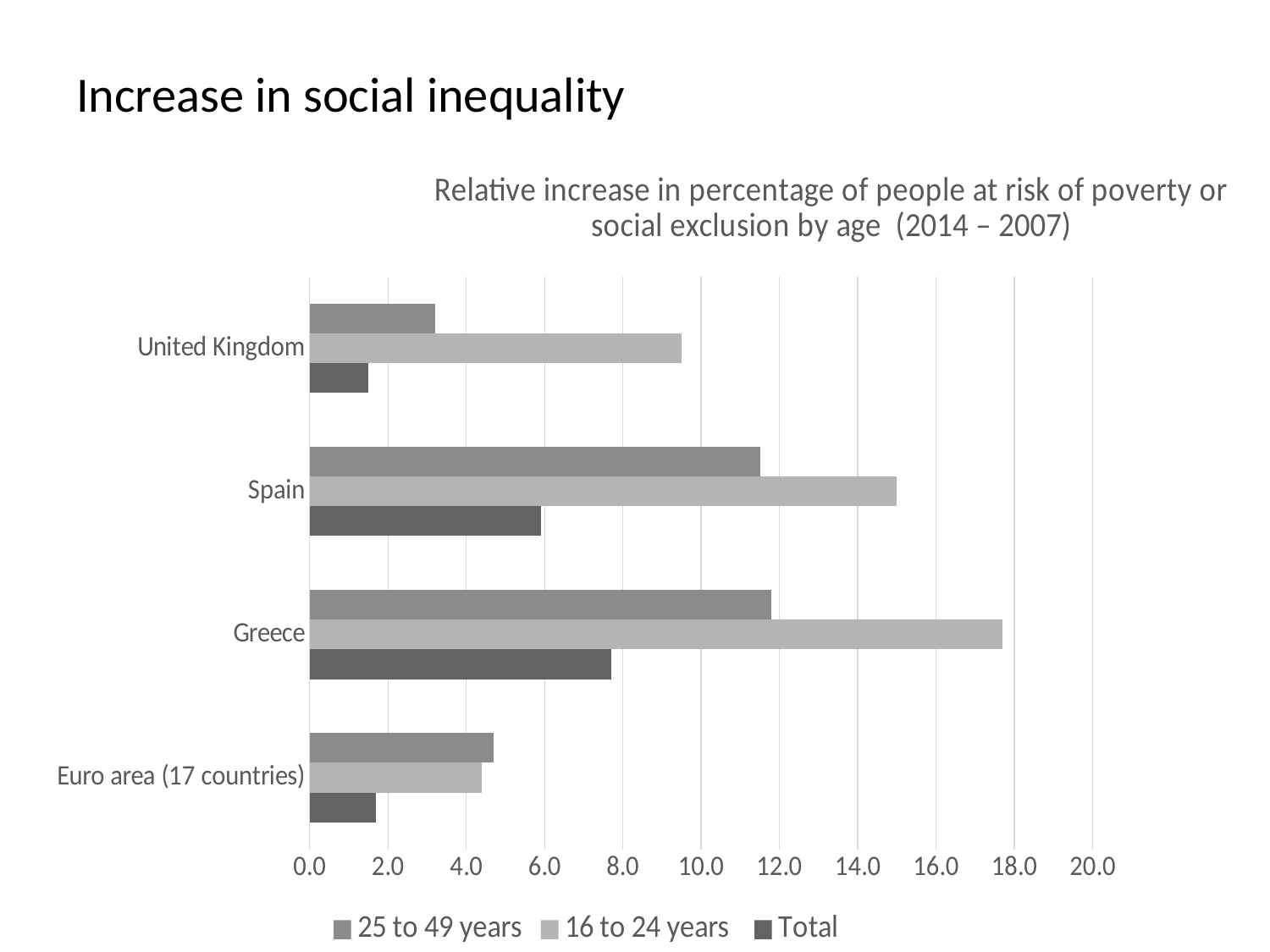
What is the title of the chart? Relative increase in percentage of people at risk of poverty or social exclusion by age (2014 – 2007) Which country or region has the highest value for the Total series? Greece Is the value for Spain in the 25 to 49 years series greater or less than 10.0? greater Is the value for the United Kingdom in the 25 to 49 years series greater or less than 4.0? less What kind of chart is shown on the slide? bar chart Is the value for Greece in the 16 to 24 years series greater or less than 16.0? greater For the 16 to 24 years series, which is larger: Spain or Greece? Greece How many series does the legend list? 3 Which country or region has the highest value for the 16 to 24 years series? Greece How many countries or regions are shown on the chart? 4 Which country or region has the lowest value for the 16 to 24 years series? Euro area (17 countries) Which country or region has the lowest value for the 25 to 49 years series? United Kingdom